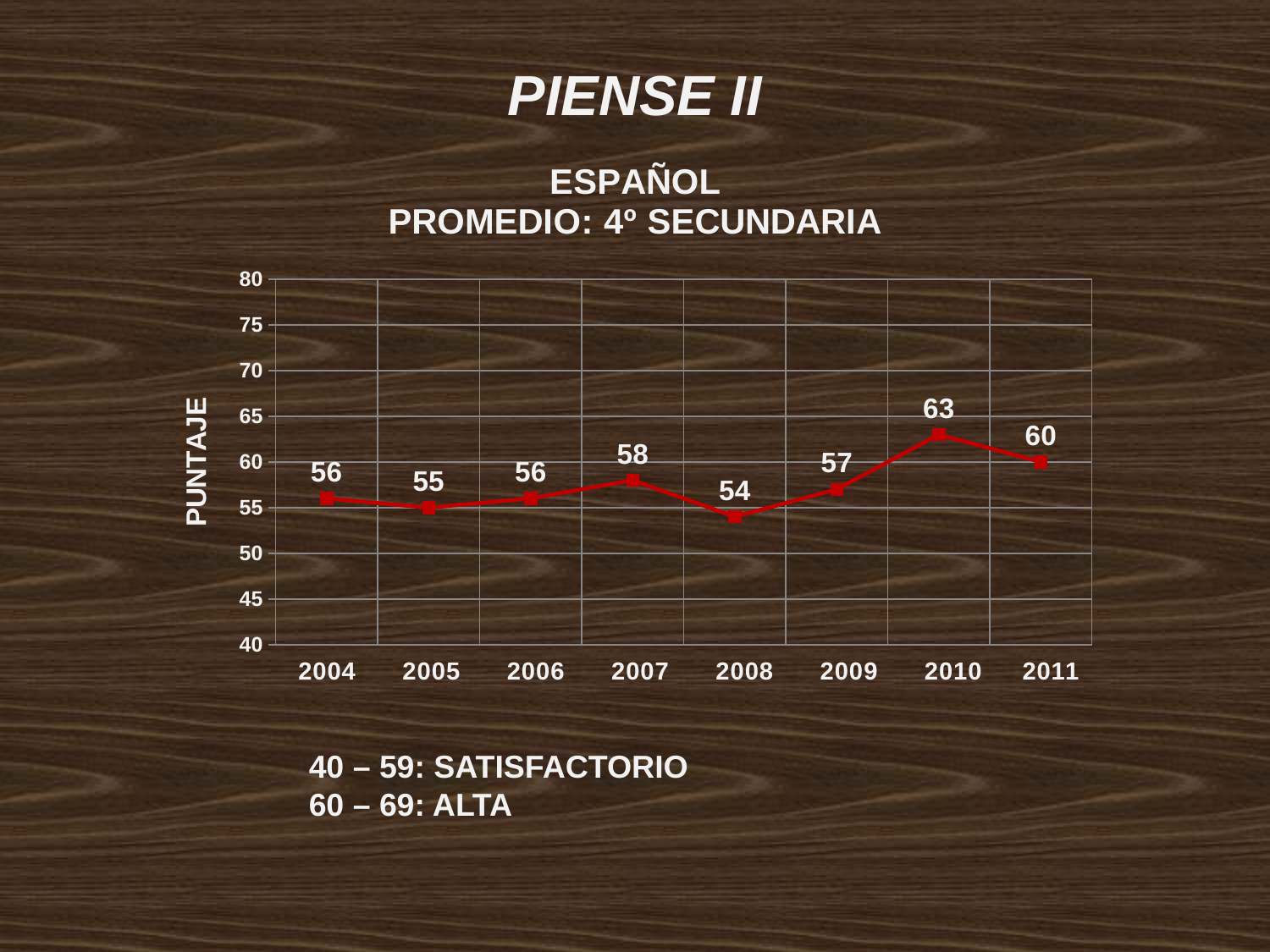
Which year has the highest value? 2010 What is the value for 2010? 63 What is the label on the y axis? PUNTAJE What is the value for 2008? 54 What kind of chart is shown? line chart Which year has the lowest value? 2008 Do the values rise or fall from 2008 to 2010? rise How many years are plotted on the x axis? 8 What is the difference between the values for 2010 and 2008? 9 Is the value for 2011 greater or less than 55? greater What is the value for 2005? 55 Which is larger, the value for 2007 or the value for 2009? 2007